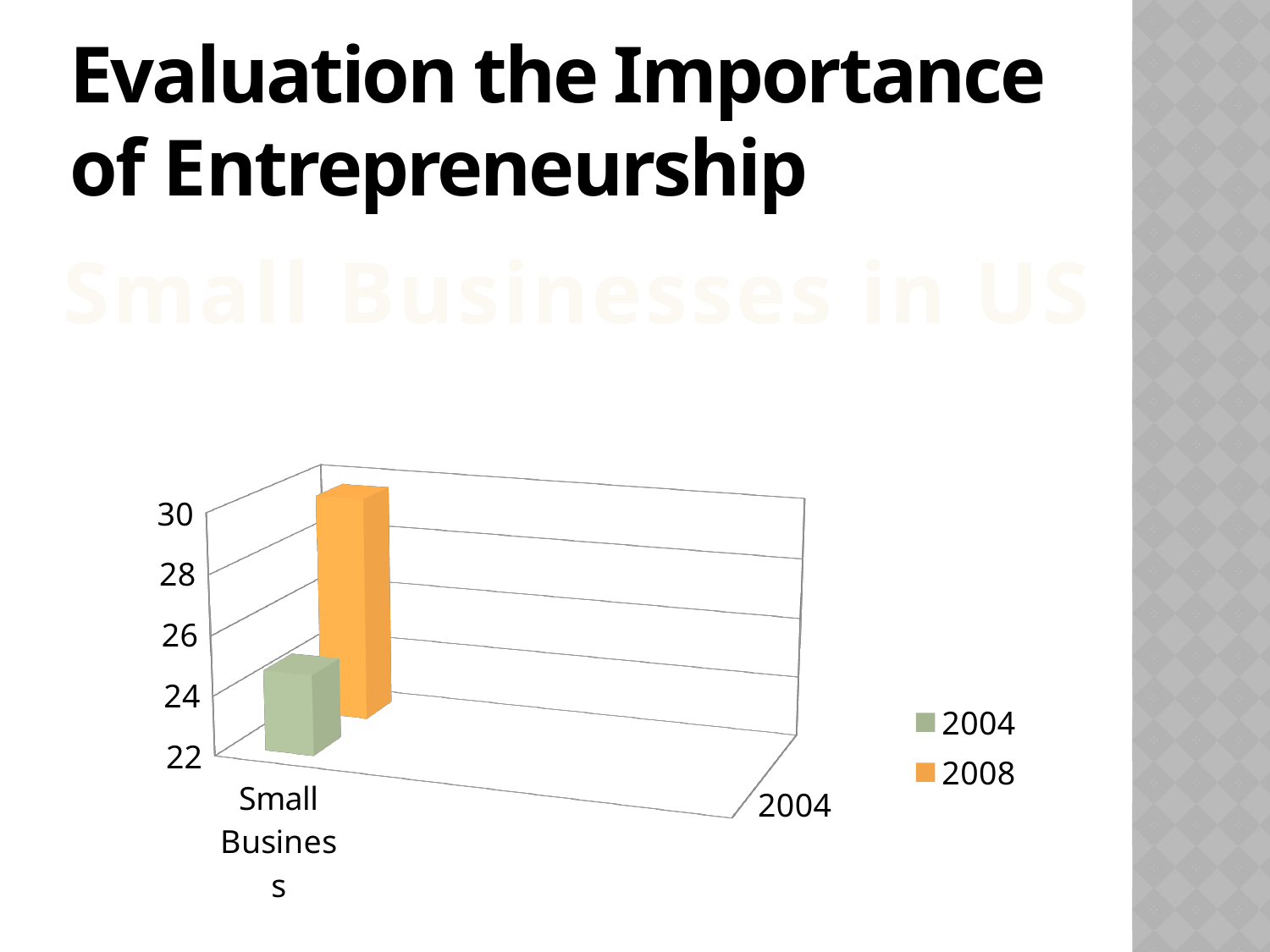
Which series has the taller bar for Small Business, 2004 or 2008? 2008 Is the 2008 value for Small Business greater or less than 28? greater Does the value for Small Business rise or fall from 2004 to 2008? rise Is the 2004 value for Small Business greater or less than 26? less Which series has the lowest value for Small Business? 2004 What is the category label on the chart's x axis? Small Business How many series does the chart legend list? 2 Is the 2004 value for Small Business greater or less than 22? greater What are the series names listed in the chart legend? 2004 and 2008 What kind of chart is shown on the slide? bar chart How many categories are shown on the chart's x axis? 1